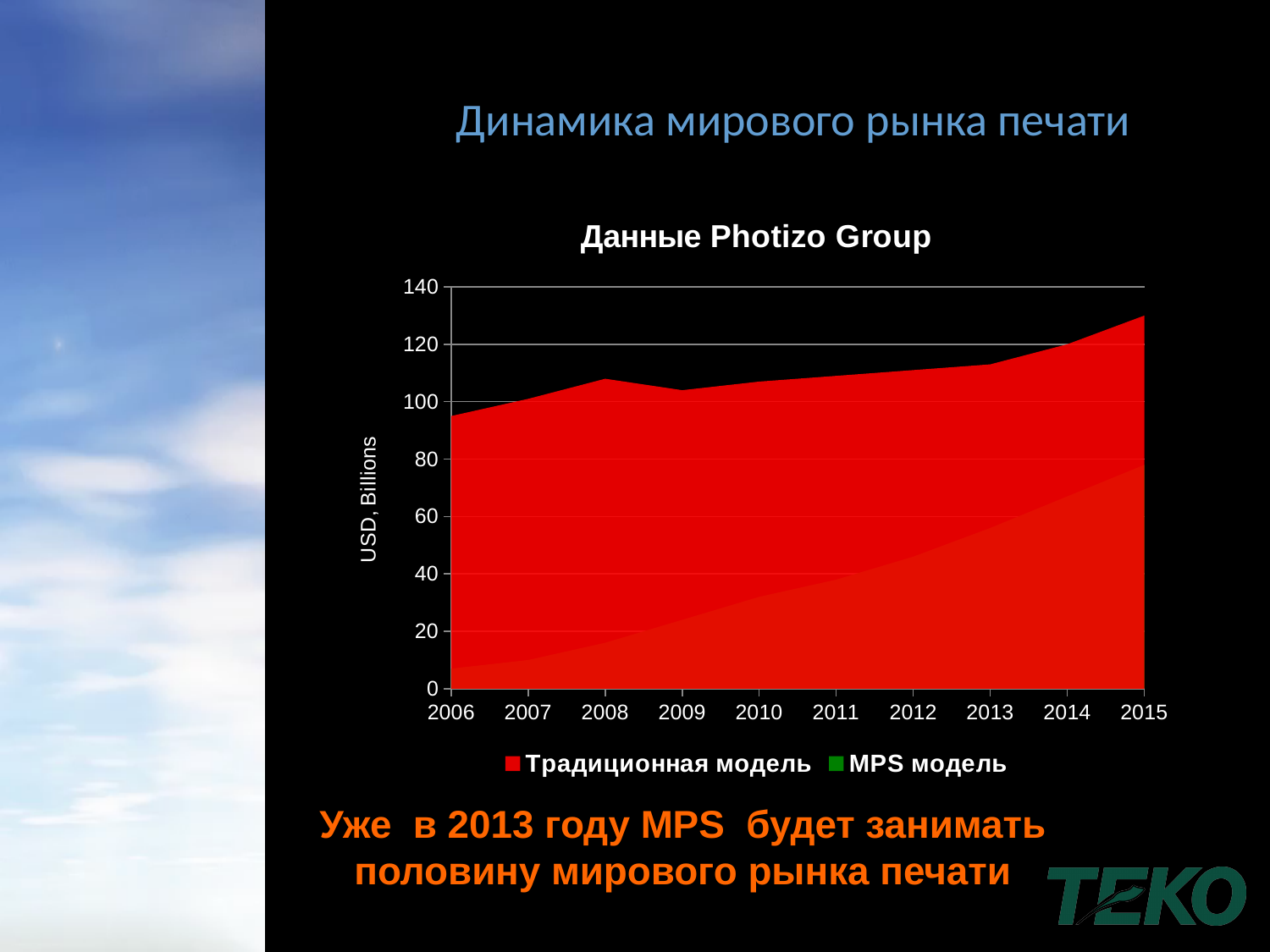
What is the first year shown on the x axis? 2006 How many series does the legend list? 2 What are the two series named in the legend? Традиционная модель and MPS модель Is the total value for 2015 greater or less than 120? greater What is the last year shown on the x axis? 2015 What kind of chart is shown on the slide? area chart How many years are shown along the x axis? 10 Does the total market value rise or fall from 2006 to 2015? rise Which year has the highest total value? 2015 What is the title of the chart? Данные Photizo Group Is the total value for 2008 greater or less than 100? greater